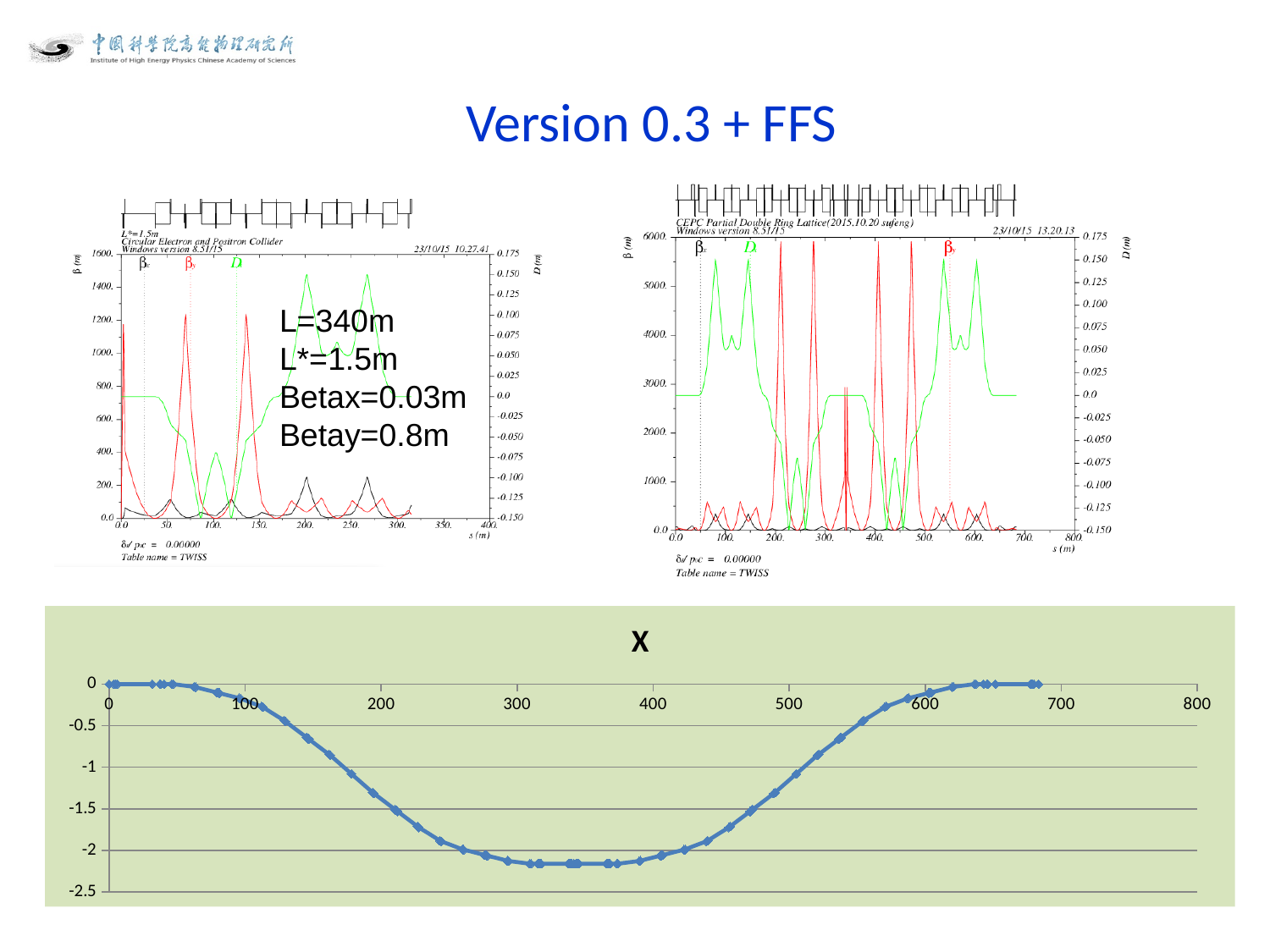
How many series are labelled in the top-left chart (βx, βy, D)? 3 In the bottom chart titled "X", does the curve fall or rise between x = 0 and x = 300? fall In the bottom chart titled "X", is the lowest point of the curve greater or less than -2.5? greater In the top-right chart, is the tallest βy (red) peak greater or less than 5000 m? greater In the bottom chart titled "X", does the curve fall or rise between x = 400 and x = 600? rise In the bottom chart titled "X", is the value at x = 100 greater or less than -0.5? greater What is the highest tick value on the left β(m) axis of the top-right chart? 6000 What kind of chart is the bottom chart titled "X"? line chart In the bottom chart titled "X", what is the lowest value shown on the y axis? -2.5